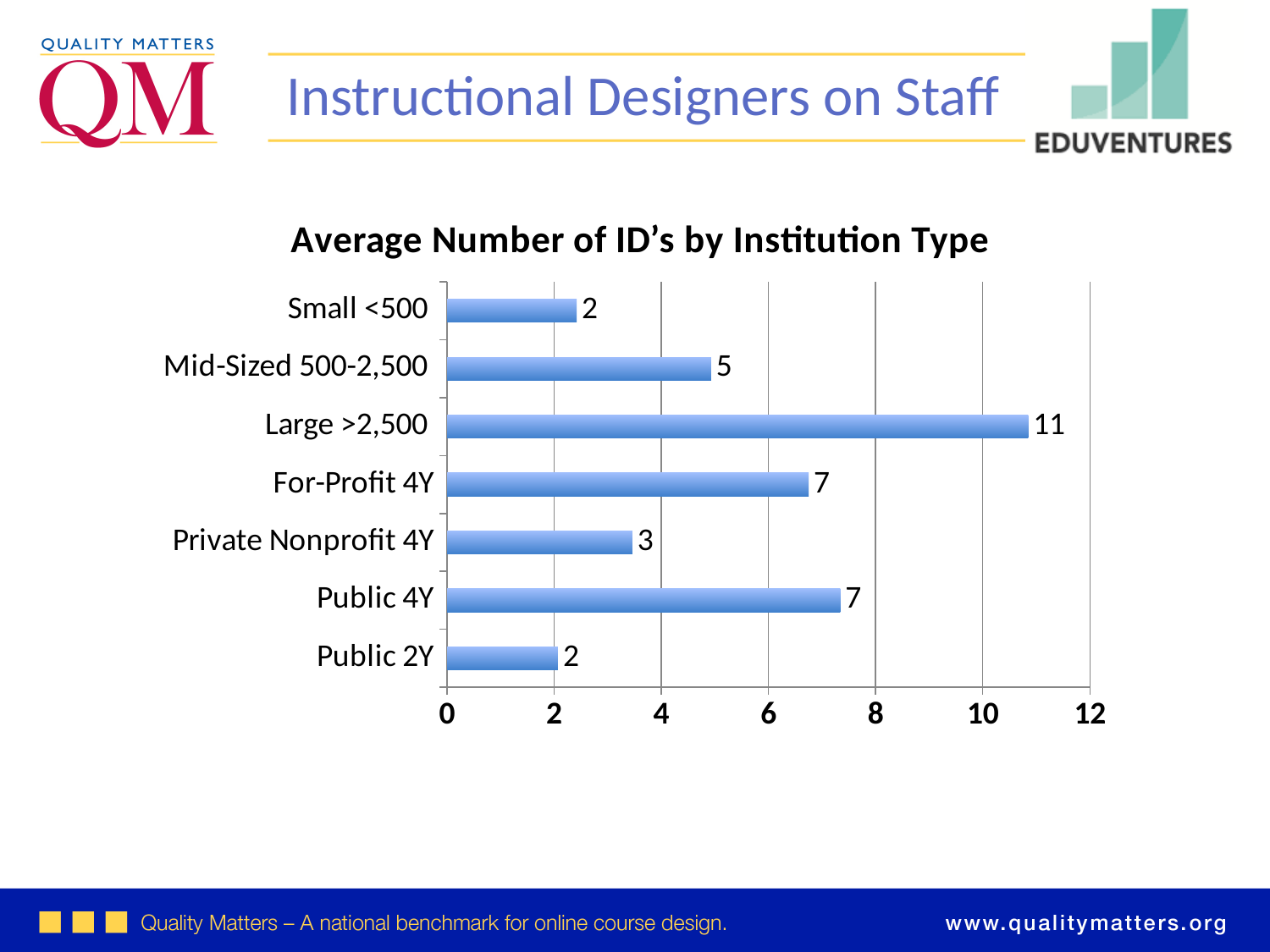
Which has a higher average number of ID's, Mid-Sized 500-2,500 or Private Nonprofit 4Y? Mid-Sized 500-2,500 What is the difference between the average number of ID's for For-Profit 4Y and Private Nonprofit 4Y institutions? 4 Is the value for Large >2,500 greater or less than 10? greater Which institution type has the highest average number of ID's? Large >2,500 Which has a higher average number of ID's, Public 4Y or Public 2Y? Public 4Y What is the difference between the average number of ID's for Large >2,500 and Mid-Sized 500-2,500 institutions? 6 What kind of chart is shown on the slide? bar chart How many institution types are shown in the chart? 7 What is the average number of ID's for Public 2Y institutions? 2 What is the average number of ID's for Private Nonprofit 4Y institutions? 3 What is the average number of ID's for Large >2,500 institutions? 11 What is the average number of ID's for Mid-Sized 500-2,500 institutions? 5